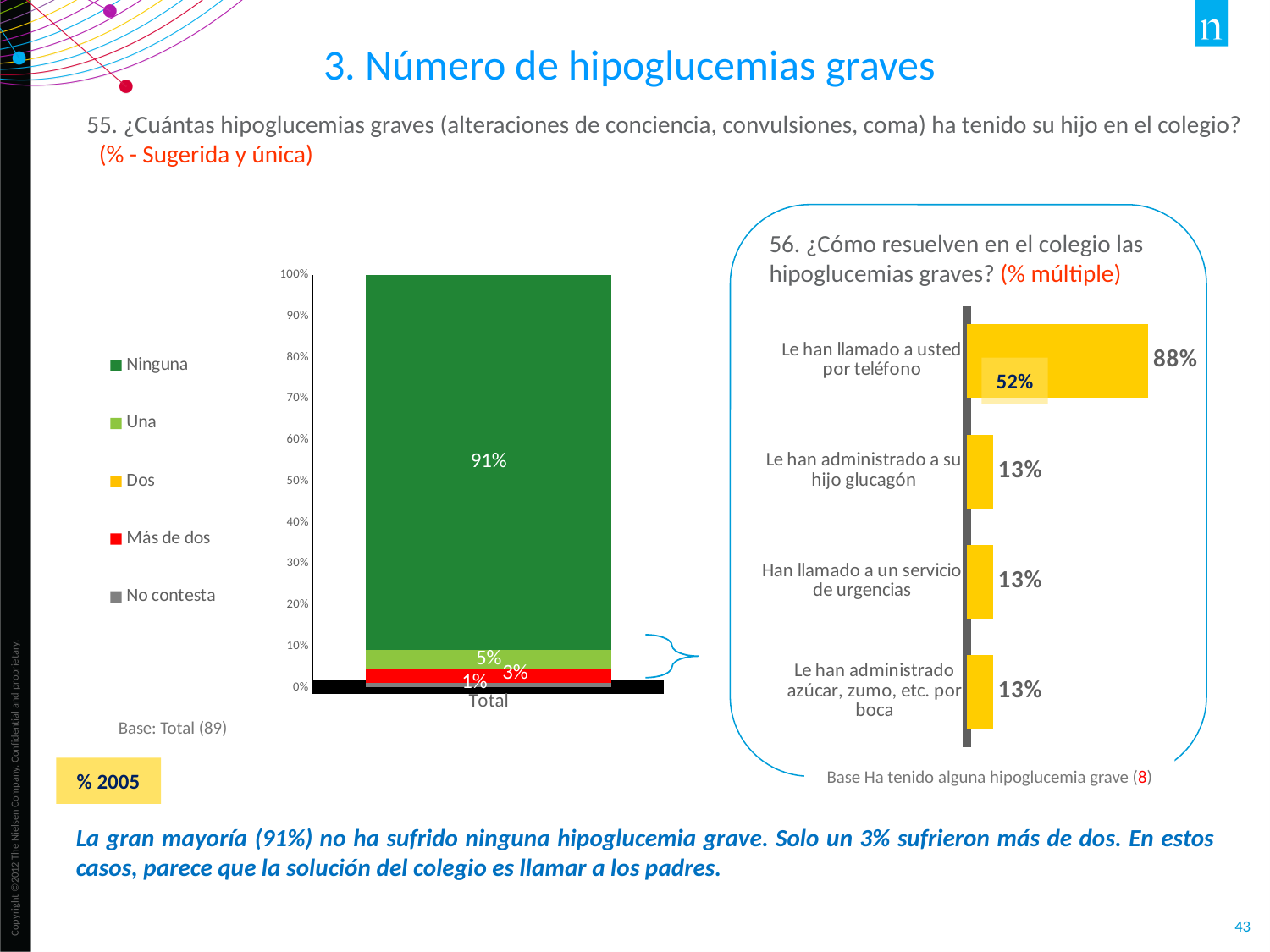
In the left stacked bar chart (question 55), how many series does the legend list? 5 In the left stacked bar chart (question 55), what percentage is shown for 'Una'? 5% In the right chart (question 56), what percentage is shown for 'Le han llamado a usted por teléfono'? 88% In the left stacked bar chart (question 55), what percentage is shown for 'Ninguna'? 91% In the right chart (question 56), how many categories are plotted? 4 What kind of chart is the right chart (question 56)? Bar chart In the left stacked bar chart (question 55), what is the difference between the 'Ninguna' and 'Una' percentages? 86% In the left stacked bar chart (question 55), what percentage is shown for 'Más de dos'? 3% In the right chart (question 56), which category has the highest value? Le han llamado a usted por teléfono In the left stacked bar chart (question 55), what colour represents 'Ninguna'? Dark green In the right chart (question 56), what percentage is shown for 'Le han administrado a su hijo glucagón'? 13% In the left stacked bar chart (question 55), which category has the largest share? Ninguna